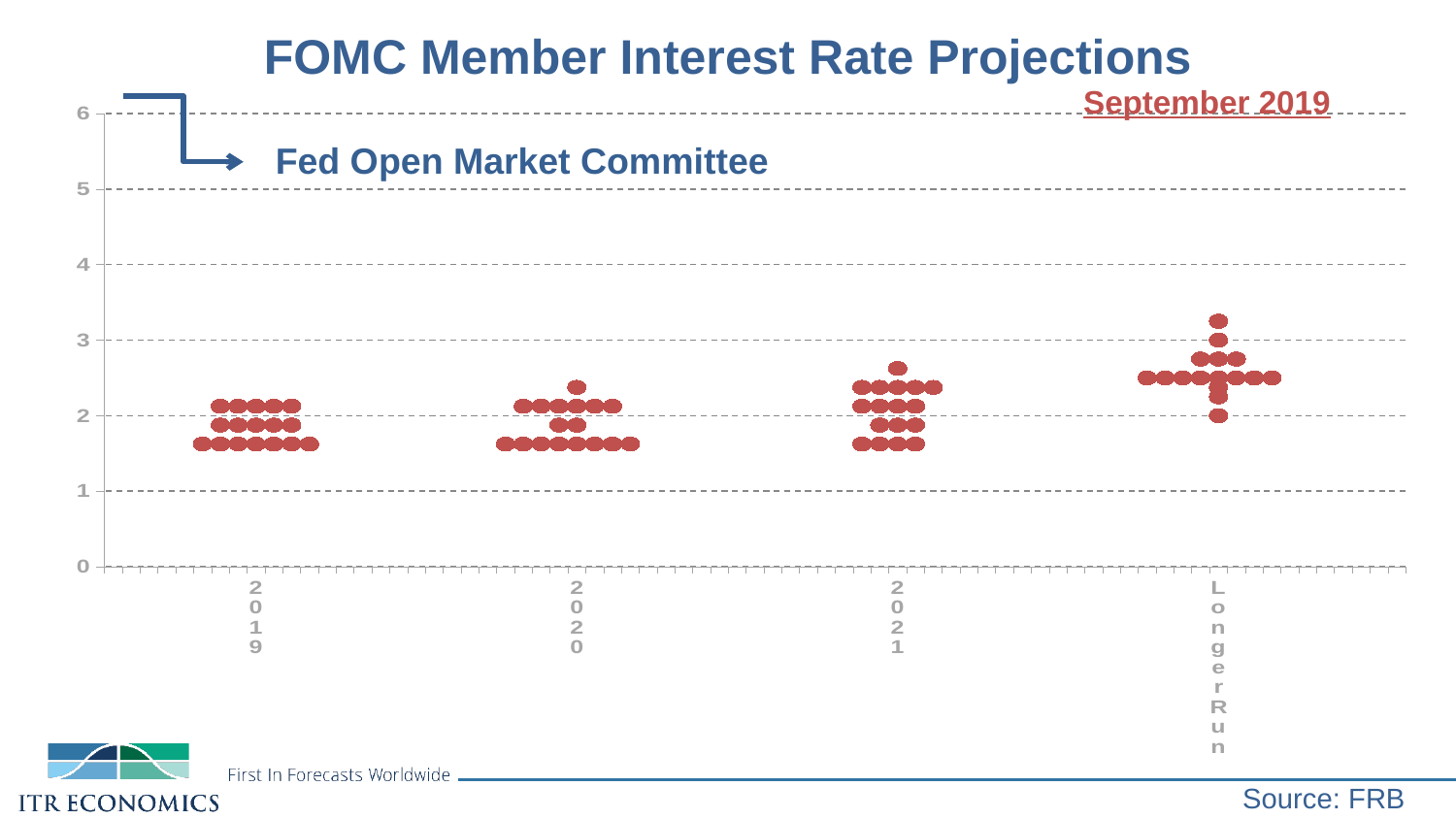
Is the highest projection for 2021 greater or less than 3? less Which has the higher top projection, 2019 or Longer Run? Longer Run Is the lowest projection for Longer Run greater or less than 1? greater What kind of chart is shown on the slide? Dot plot (scatter chart) How many categories are shown along the x axis? 4 Which category contains the highest interest rate projection? Longer Run What are the categories along the x axis? 2019, 2020, 2021, Longer Run What is the title of the chart? FOMC Member Interest Rate Projections Is the lowest projection for 2020 greater or less than 2? less Do the projections generally rise or fall moving from 2019 to Longer Run? rise